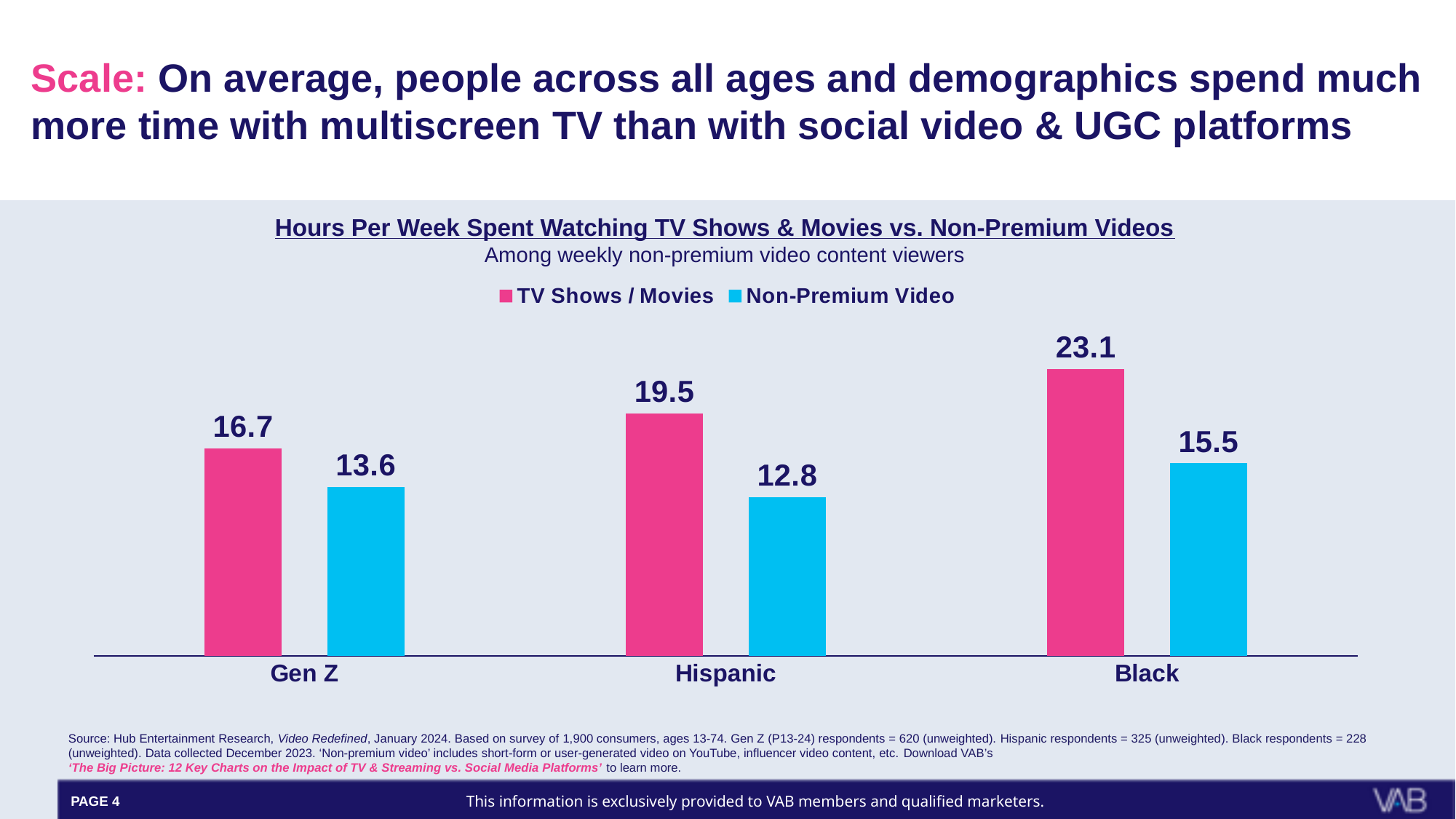
Which is larger for Hispanic: TV Shows / Movies or Non-Premium Video? TV Shows / Movies Which category has the lowest Non-Premium Video value? Hispanic What kind of chart is shown on the slide? Bar chart What colour are the Non-Premium Video bars? Blue What is the value for Non-Premium Video for Hispanic? 12.8 What is the difference between TV Shows / Movies and Non-Premium Video for Gen Z? 3.1 Which category has the highest TV Shows / Movies value? Black How many categories are shown on the x axis? 3 How many series does the legend list? 2 What is the value for Non-Premium Video for Black? 15.5 What is the difference between TV Shows / Movies and Non-Premium Video for Black? 7.6 What is the value for TV Shows / Movies for Gen Z? 16.7